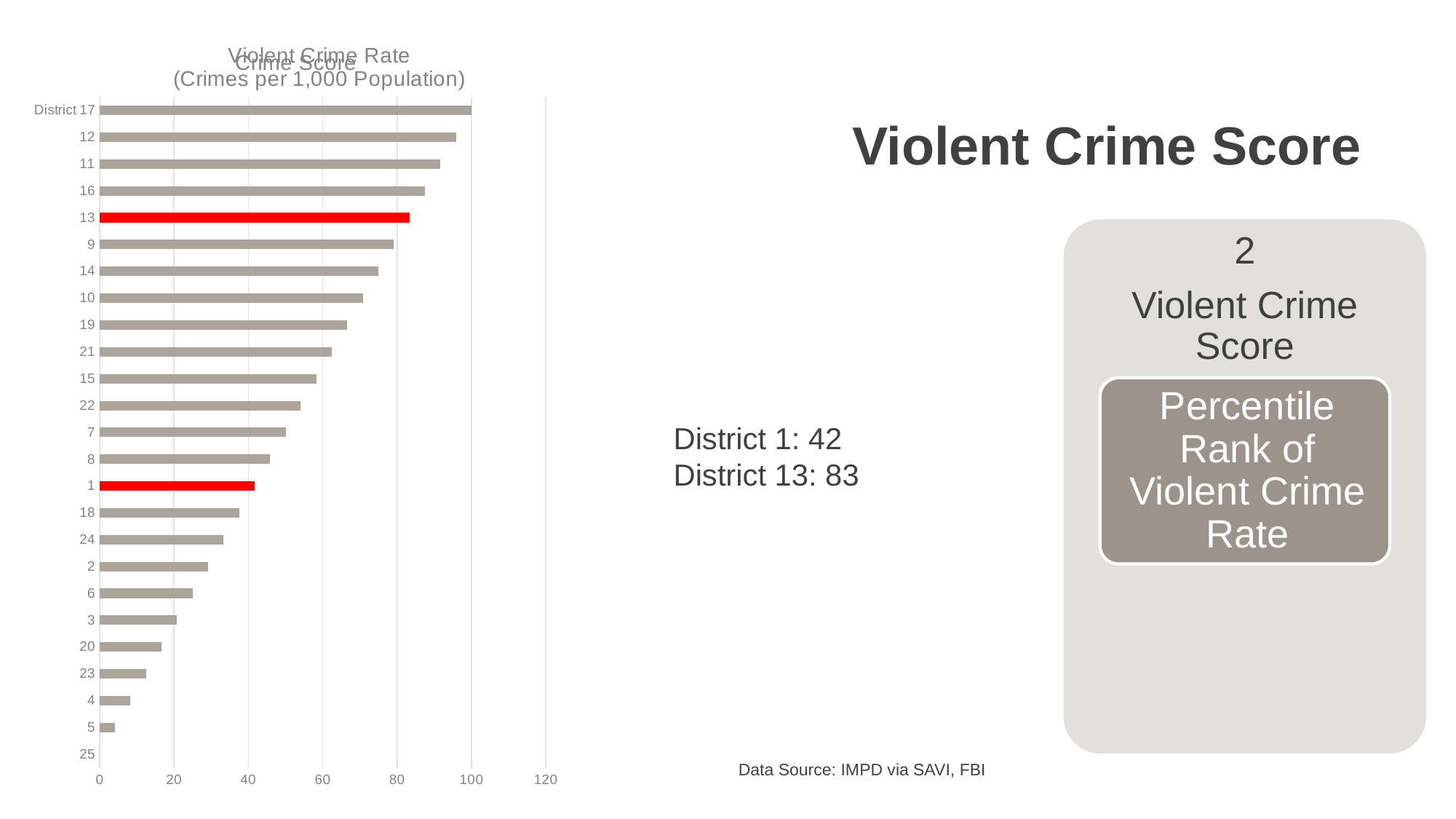
Is the value for District 18 greater or less than 40? less What kind of chart is shown on the slide? bar chart Is the value for District 21 greater or less than 60? greater Is the value for District 16 greater or less than 80? greater Which has the larger value, District 9 or District 14? District 9 Which districts' bars are highlighted in red? District 13 and District 1 Which district has the highest value in the chart? District 17 What is the value for District 1? 42 What is the value for District 13? 83 What is the difference between the values for District 13 and District 1? 41 Which has the larger value, District 12 or District 11? District 12 How many districts are listed on the chart's vertical axis? 25